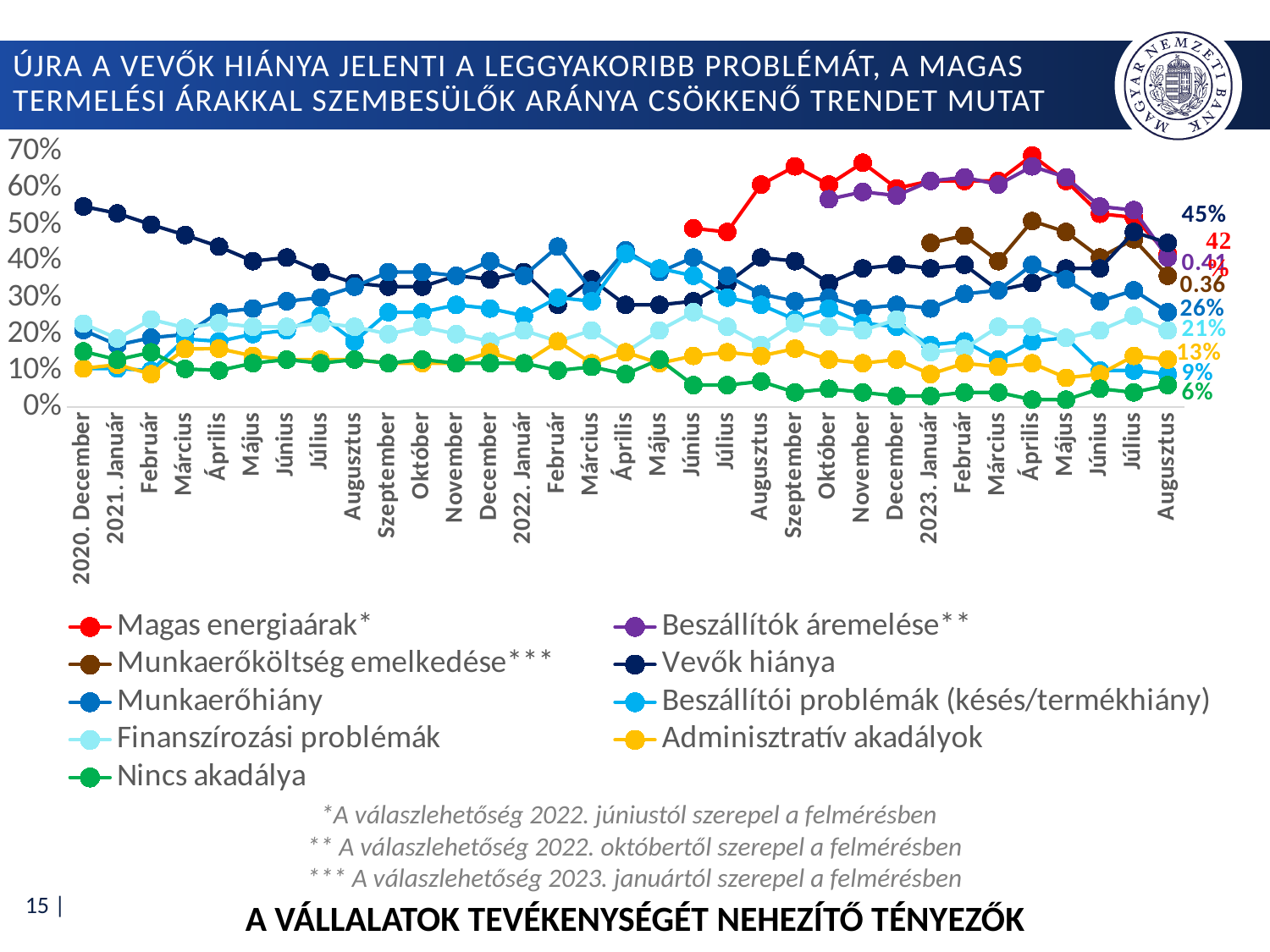
What is the value for Adminisztratív akadályok at the last point (Augusztus 2023)? 13% Is the value for Vevők hiánya in 2020. December greater or less than 50%? greater At the last point, which is larger: Finanszírozási problémák or Beszállítói problémák (késés/termékhiány)? Finanszírozási problémák What is the value for Nincs akadálya at the last point (Augusztus 2023)? 6% Which series has the highest value at the last point (Augusztus 2023)? Vevők hiánya What is the value for Vevők hiánya at the last point (Augusztus 2023)? 45% What is the difference between Vevők hiánya (45%) and Munkaerőhiány (26%) at the last point? 19 percentage points How many series does the legend list? 9 What type of chart is shown on the slide? line chart Which series has the lowest value at the last point (Augusztus 2023)? Nincs akadálya What is the value for Munkaerőhiány at the last point (Augusztus 2023)? 26% Which series is drawn in red in the legend? Magas energiaárak*